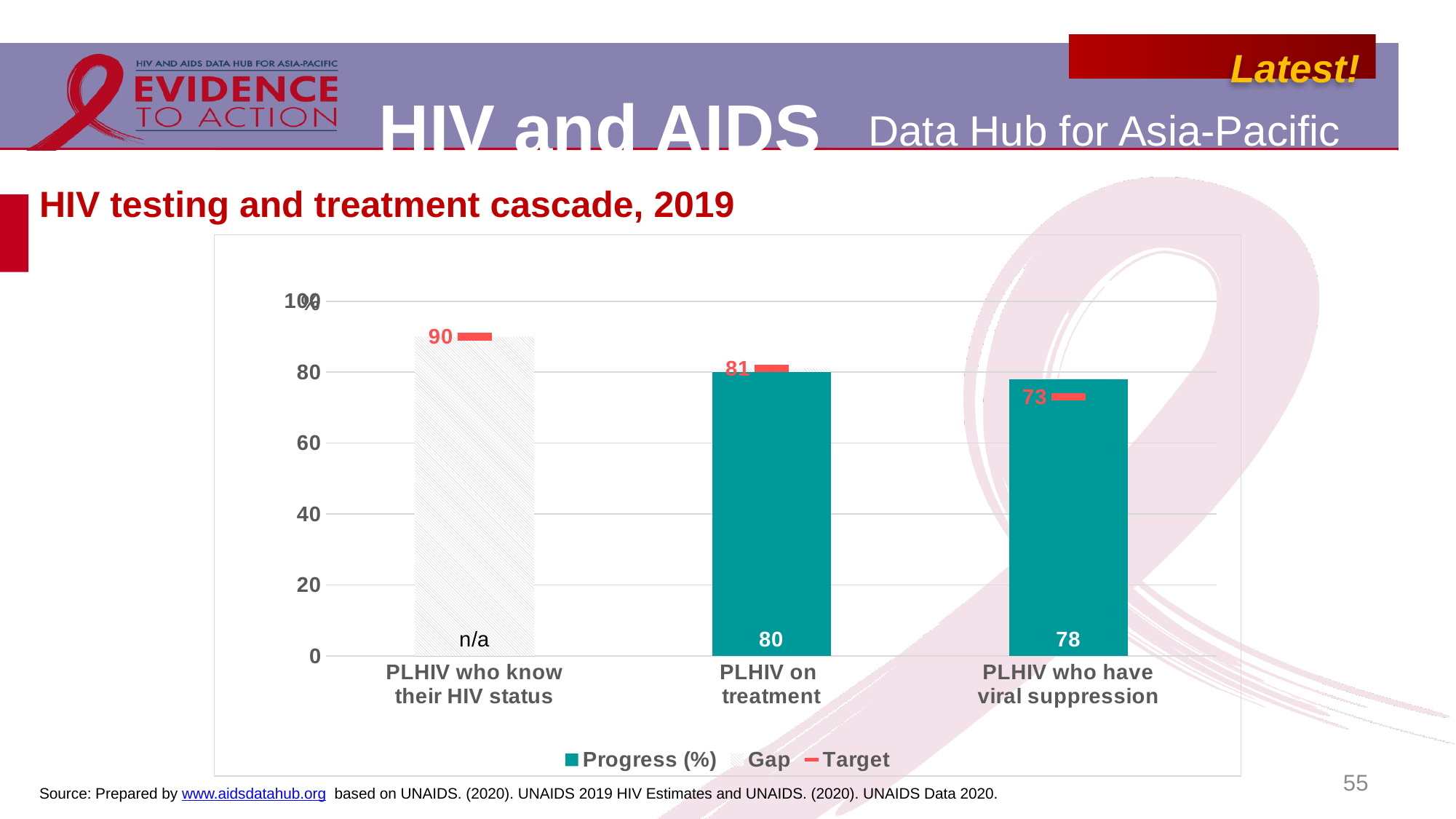
Which is larger: the Progress (%) for PLHIV on treatment or the Target for PLHIV on treatment? Target for PLHIV on treatment How many categories are shown on the x axis of the chart? 3 What is the Progress (%) value for PLHIV on treatment? 80 Is the Progress (%) value for PLHIV who have viral suppression greater or less than 80? less What is the Target value for PLHIV who know their HIV status? 90 What is the Progress (%) value for PLHIV who have viral suppression? 78 What is the difference between the Progress (%) values for PLHIV on treatment and PLHIV who have viral suppression? 2 What is the Target value for PLHIV on treatment? 81 What is the title of the chart? HIV testing and treatment cascade, 2019 How many series does the chart legend list? 3 What is the Target value for PLHIV who have viral suppression? 73 What is the Progress (%) value shown for PLHIV who know their HIV status? n/a